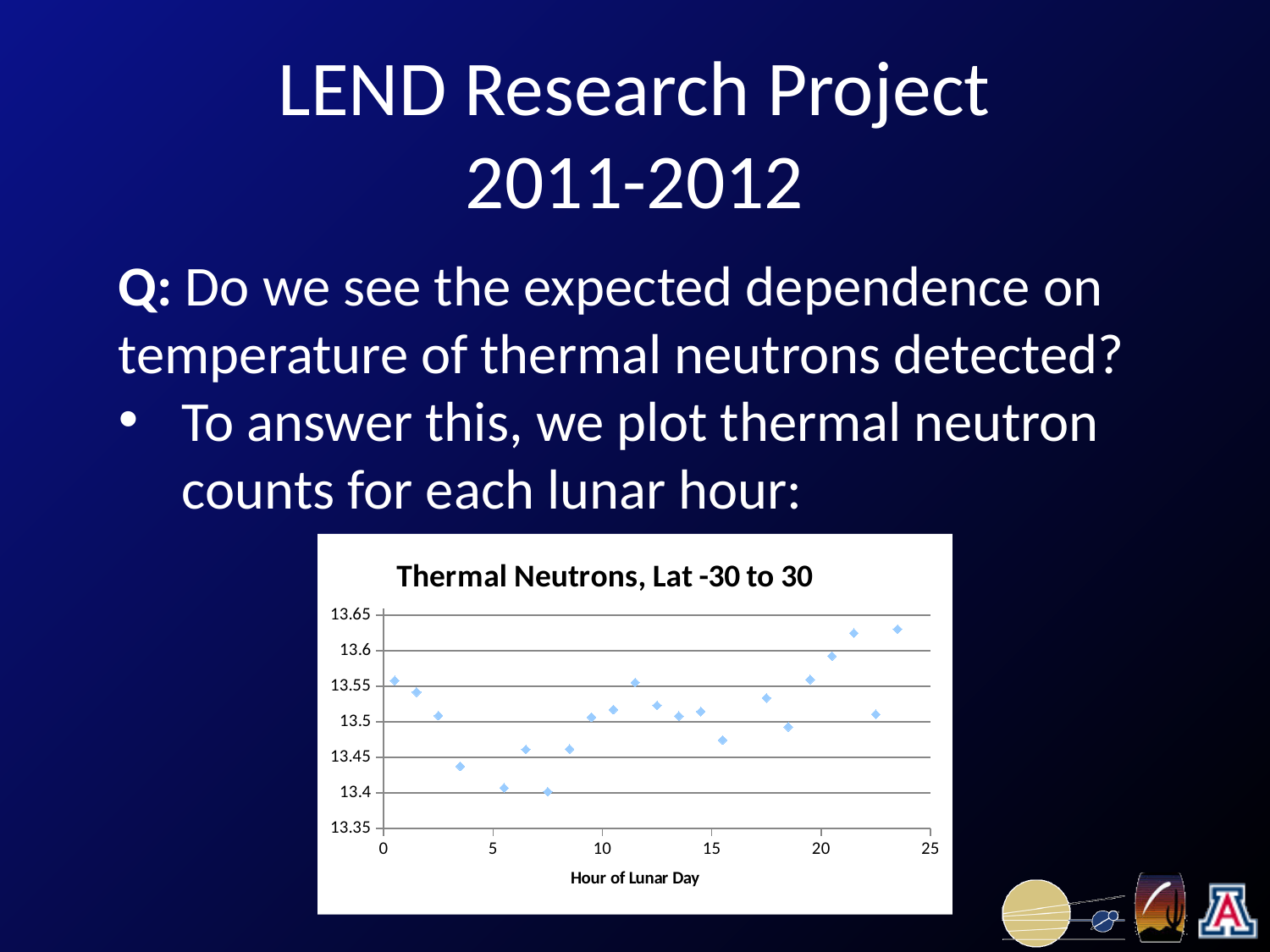
Which is larger, the value at hour 0.5 or the value at hour 5.5 of the lunar day? hour 0.5 Between hour 0 and hour 7.5 of the lunar day, do the plotted values generally rise or fall? fall What kind of chart is shown on the slide? scatter chart Is the value at hour 7.5 of the lunar day greater or less than 13.45? less Is the value at hour 21.5 of the lunar day greater or less than 13.6? greater Is the value at hour 5.5 of the lunar day greater or less than 13.45? less What is the title of the chart? Thermal Neutrons, Lat -30 to 30 Which is larger, the value at hour 21.5 or the value at hour 7.5 of the lunar day? hour 21.5 What is the label of the x axis of the chart? Hour of Lunar Day